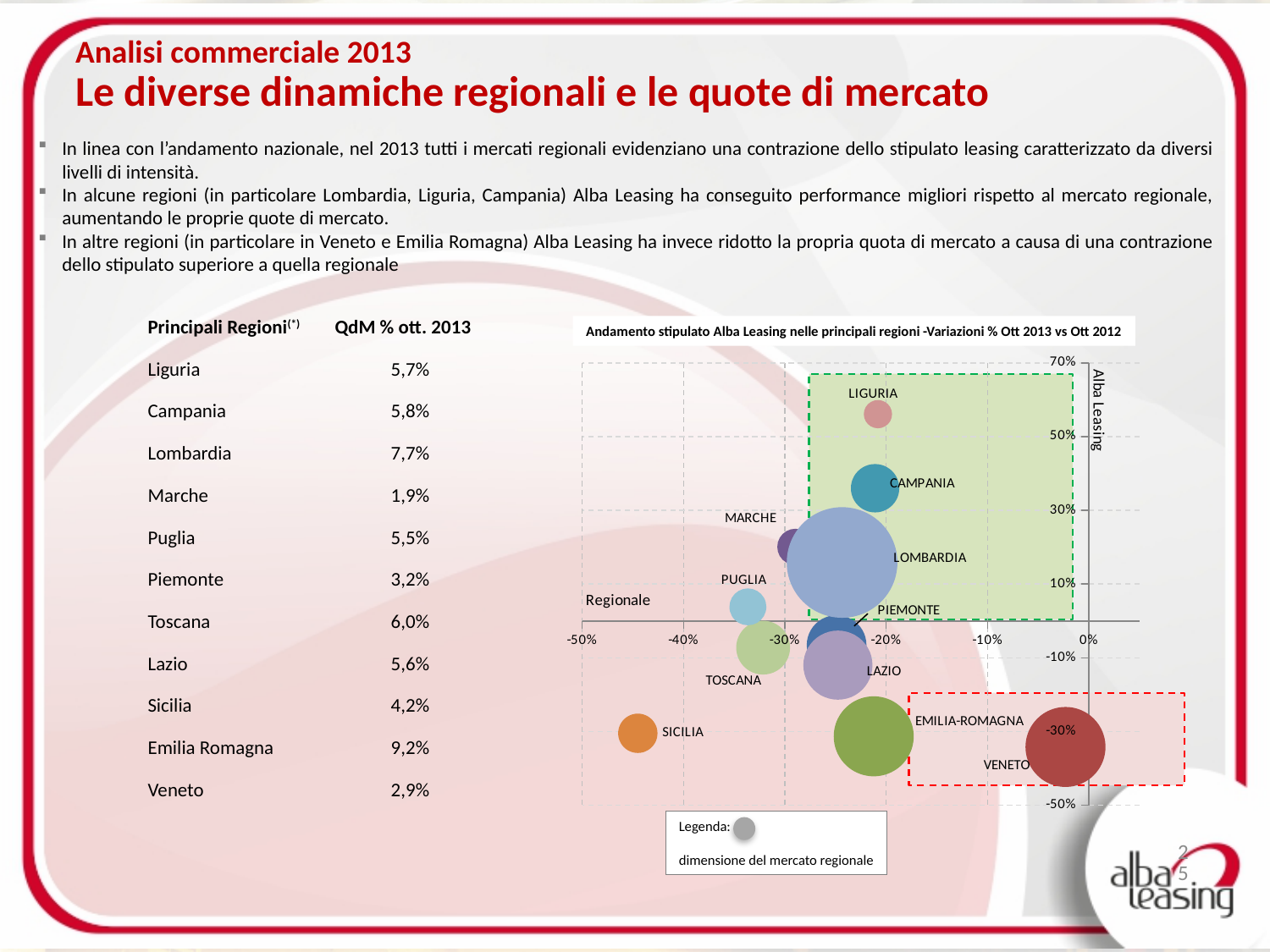
Is the Alba Leasing variation for Campania greater or less than 30%? greater Which region has the highest Alba Leasing variation (vertical axis) in the chart? Liguria Is the regional variation (horizontal axis) for Sicilia greater or less than -40%? less According to the chart legend, what does the bubble size represent? dimensione del mercato regionale Is the Alba Leasing variation for Liguria greater or less than 50%? greater Which region has the lowest Alba Leasing variation (vertical axis) in the chart? Veneto How many regions are plotted as bubbles in the chart? 11 Which region is represented by the largest bubble in the chart? Lombardia Which region has a higher Alba Leasing variation, Liguria or Campania? Liguria What kind of chart is shown on the slide? bubble chart